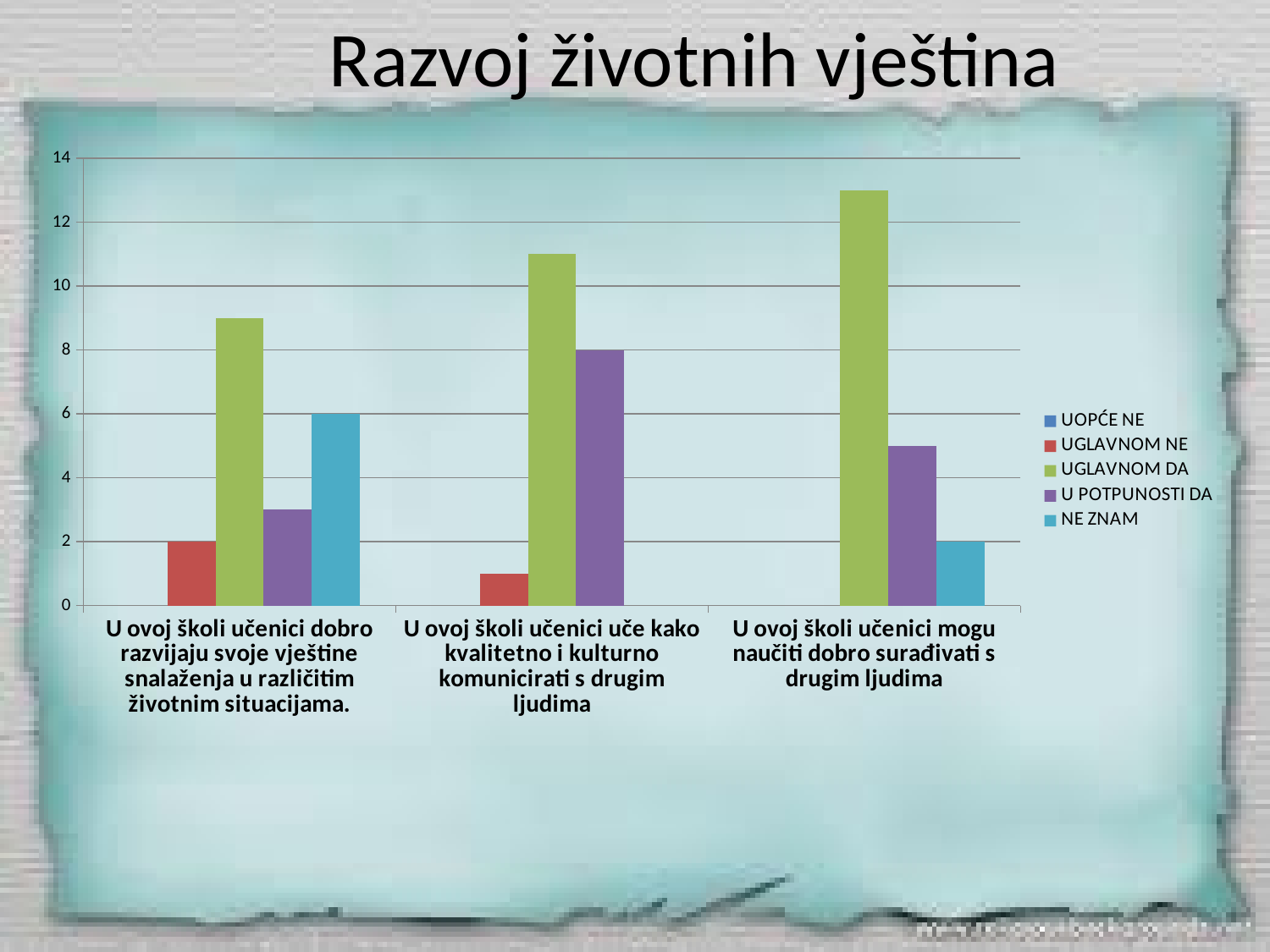
Is the UGLAVNOM DA value for "U ovoj školi učenici mogu naučiti dobro surađivati s drugim ljudima" greater or less than 12? greater How many series does the legend list? 5 What is the title of the slide? Razvoj životnih vještina What is the U POTPUNOSTI DA value for the statement "U ovoj školi učenici uče kako kvalitetno i kulturno komunicirati s drugim ljudima"? 8 How many categories (statements) are shown on the x axis? 3 What is the NE ZNAM value for the statement "U ovoj školi učenici dobro razvijaju svoje vještine snalaženja u različitim životnim situacijama."? 6 For the statement "U ovoj školi učenici uče kako kvalitetno i kulturno komunicirati s drugim ljudima", which is larger: UGLAVNOM DA or U POTPUNOSTI DA? UGLAVNOM DA What kind of chart is shown on the slide? Bar chart Which statement has the highest UGLAVNOM DA value? U ovoj školi učenici mogu naučiti dobro surađivati s drugim ljudima What is the NE ZNAM value for the statement "U ovoj školi učenici mogu naučiti dobro surađivati s drugim ljudima"? 2 What is the UGLAVNOM NE value for the statement "U ovoj školi učenici dobro razvijaju svoje vještine snalaženja u različitim životnim situacijama."? 2 What is the difference between the NE ZNAM value for the first statement and the NE ZNAM value for the third statement? 4